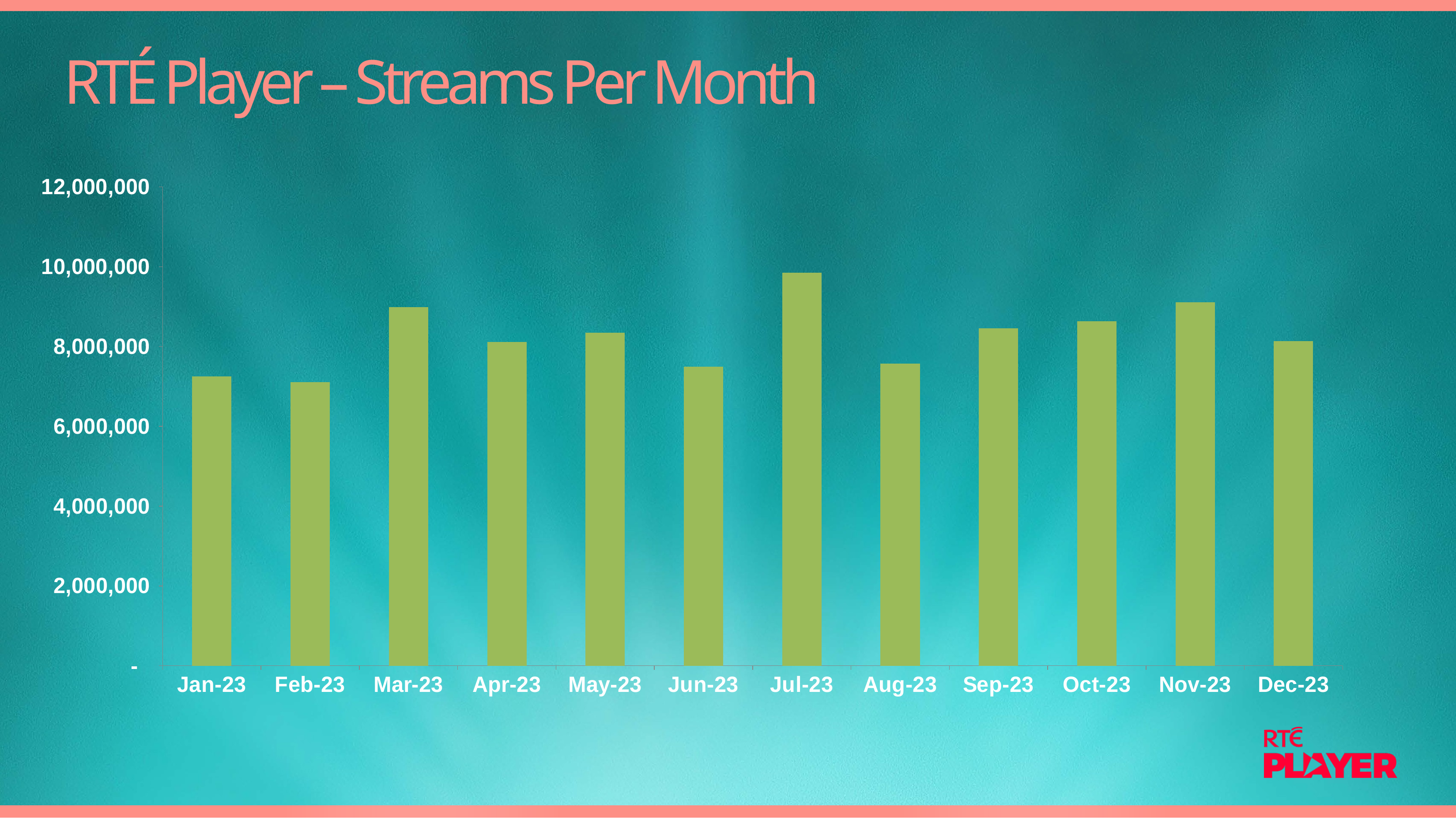
Is the value for Jul-23 greater or less than 8,000,000? greater Is the value for Nov-23 greater or less than 8,000,000? greater Is the value for Jan-23 greater or less than 8,000,000? less Do the values rise or fall from Jun-23 to Jul-23? rise Which month has the highest number of streams? Jul-23 What kind of chart is shown on the slide? bar chart What is the title of the chart on the slide? RTÉ Player – Streams Per Month Which is larger, the value for Jul-23 or the value for Jan-23? Jul-23 Which is larger, the value for Mar-23 or the value for Feb-23? Mar-23 How many months are plotted on the chart? 12